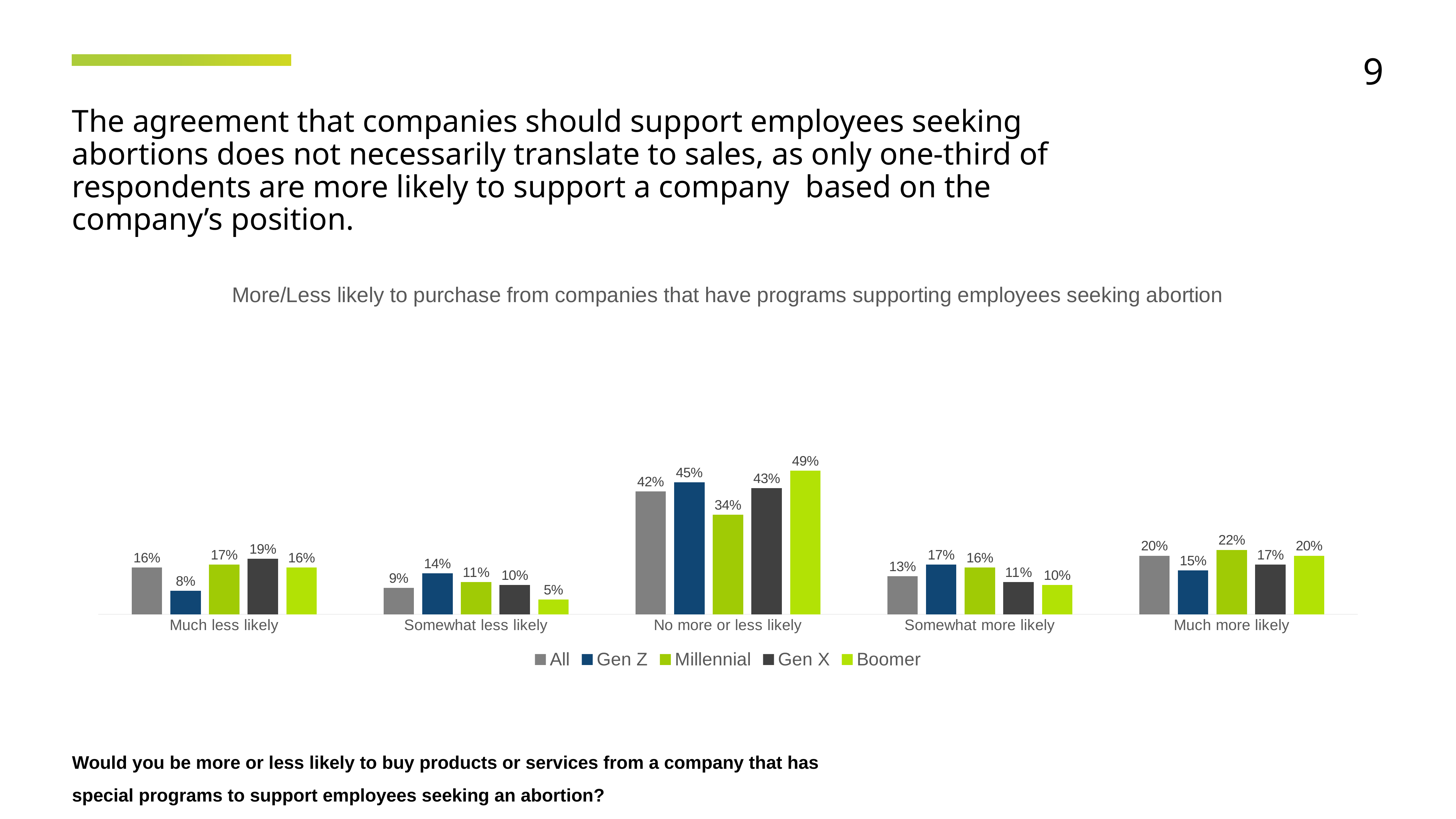
Which series has the highest value in the 'No more or less likely' category? Boomer Which series has the lowest value in the 'Somewhat less likely' category? Boomer Which is larger in the 'Much more likely' category: the Gen Z value or the Boomer value? Boomer What is the title of the chart? More/Less likely to purchase from companies that have programs supporting employees seeking abortion How many categories are shown on the x axis? 5 What is the value for Millennial in the 'Much more likely' category? 22% What kind of chart is shown on the slide? Bar chart What is the difference between the Boomer and Millennial values in the 'No more or less likely' category? 15% How many series does the legend list? 5 What is the value for All in the 'Somewhat more likely' category? 13% What is the value for Gen Z in the 'Much less likely' category? 8% What is the value for Boomer in the 'No more or less likely' category? 49%